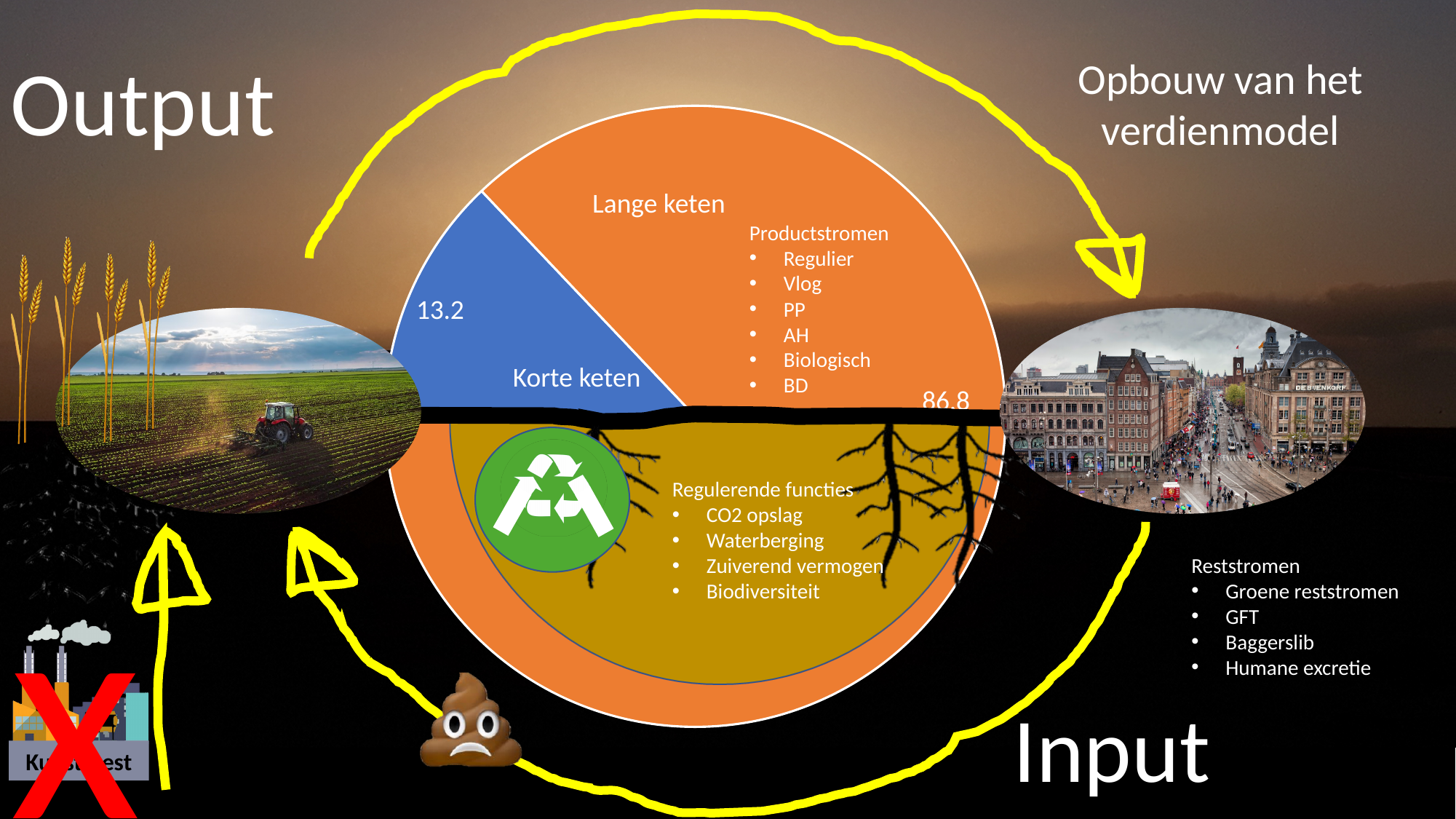
Which is larger, Lange keten or Korte keten? Lange keten What share of the pie does the Korte keten slice represent? 13.2 What is the value shown for the Korte keten slice? 13.2 What kind of chart is shown in the centre of the slide? pie chart Which slice of the pie chart is the largest? Lange keten What colour is the Korte keten slice? blue What is the difference between the Lange keten value and the Korte keten value? 73.6 What is the value shown for the Lange keten slice? 86.8 How many slices does the pie chart have? 2 Which slice of the pie chart is the smallest? Korte keten Which slice of the pie chart is coloured orange? Lange keten